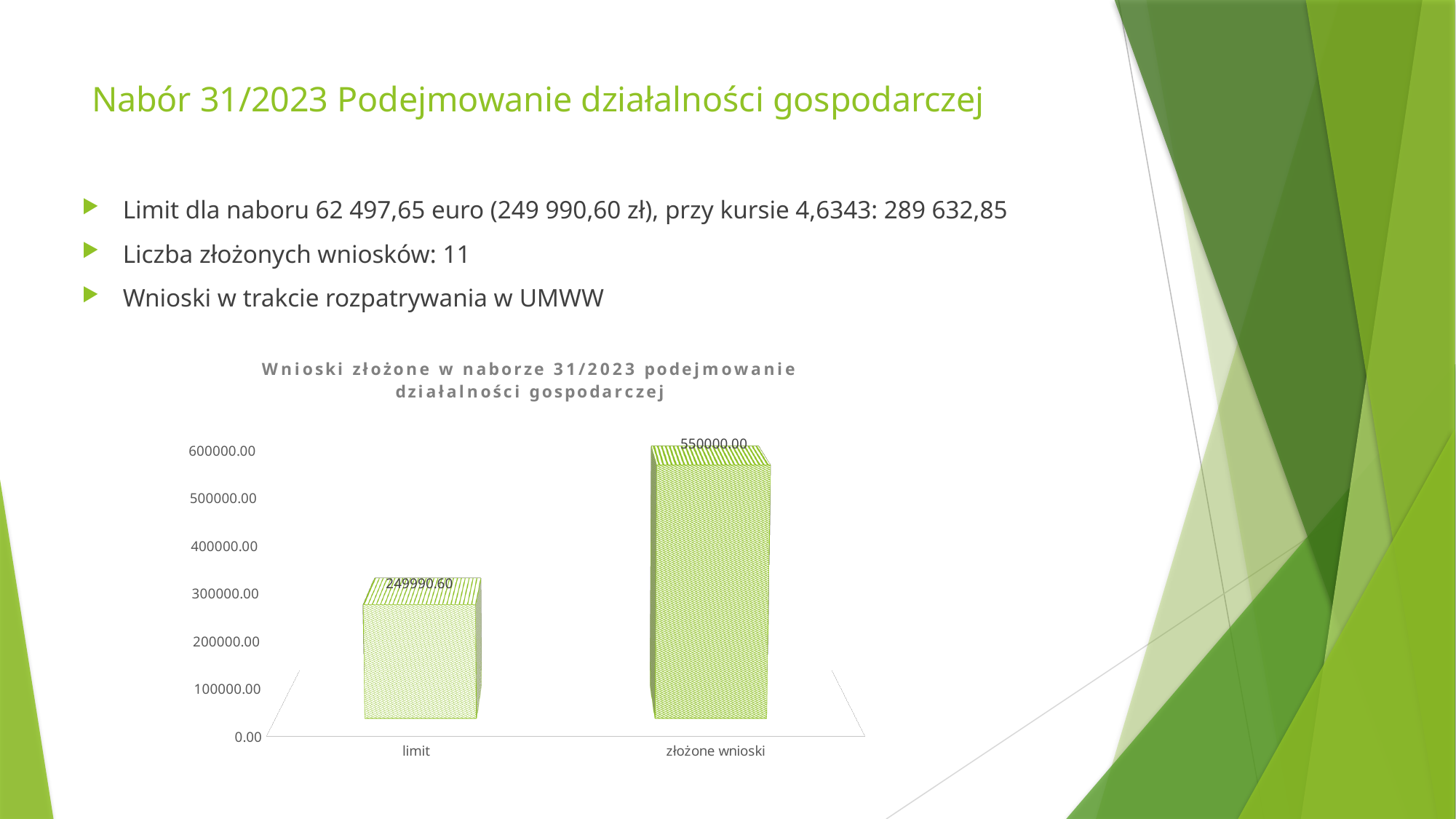
Which category has the highest value? złożone wnioski What is the title of the chart? Wnioski złożone w naborze 31/2023 podejmowanie działalności gospodarczej How many categories are shown on the x axis? 2 What is the value for "limit"? 249990.60 Is the value for "limit" greater or less than 300000.00? less Which category has the lowest value? limit What is the highest tick value shown on the y axis? 600000.00 Is the value for "złożone wnioski" greater or less than 500000.00? greater Which is larger, the value for "limit" or the value for "złożone wnioski"? złożone wnioski What is the value for "złożone wnioski"? 550000.00 What kind of chart is shown on the slide? bar chart What is the difference between the value for "złożone wnioski" and the value for "limit"? 300009.40